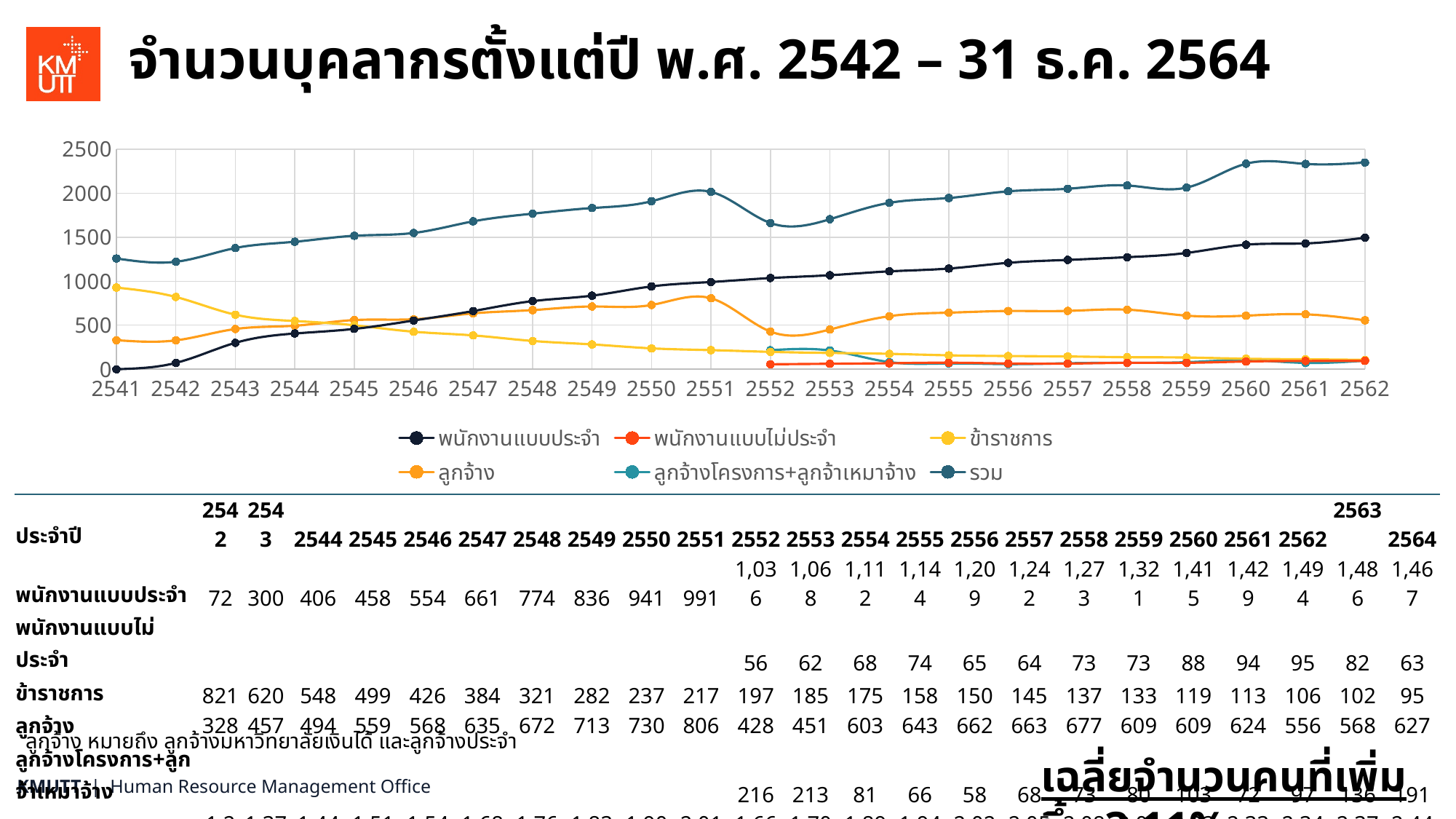
Does the ข้าราชการ series rise or fall from 2541 to 2562? fall Is the value of รวม in 2560 greater or less than 2000? greater What colour is the line for ข้าราชการ in the chart? yellow What kind of chart is shown on the slide? line chart According to the table, what is the value of พนักงานแบบประจำ for 2551? 991 How many series does the chart legend list? 6 In 2542, which is larger: ข้าราชการ or ลูกจ้าง? ข้าราชการ Which series has the highest values across the chart? รวม According to the table, what is the value of ลูกจ้าง for 2551? 806 According to the table, what is the value of ข้าราชการ for 2542? 821 How many years are labelled along the x axis of the chart? 22 Is the value of พนักงานแบบประจำ in 2543 greater or less than 500? less